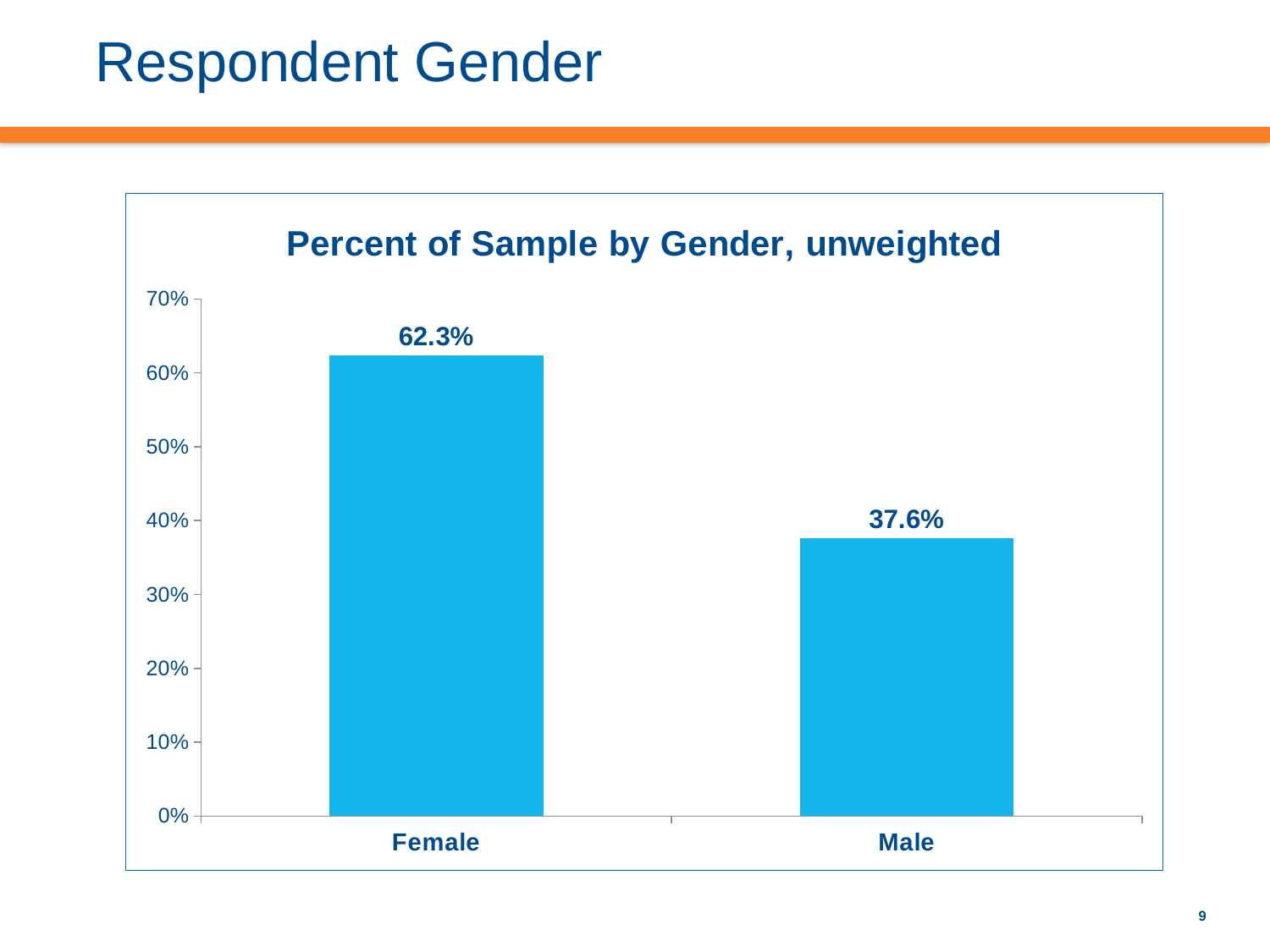
What is the highest value shown on the y axis? 70% Is the value for Female greater or less than 60%? greater Is the value for Male greater or less than 40%? less What percentage of the sample is Female? 62.3% Which gender has the highest percentage of the sample? Female What is the title of the chart? Percent of Sample by Gender, unweighted What percentage of the sample is Male? 37.6% What kind of chart is shown on the slide? bar chart How many categories are shown on the x axis? 2 Which is larger, the percentage for Female or for Male? Female What is the difference in percentage points between Female and Male? 24.7 Which gender has the lowest percentage of the sample? Male